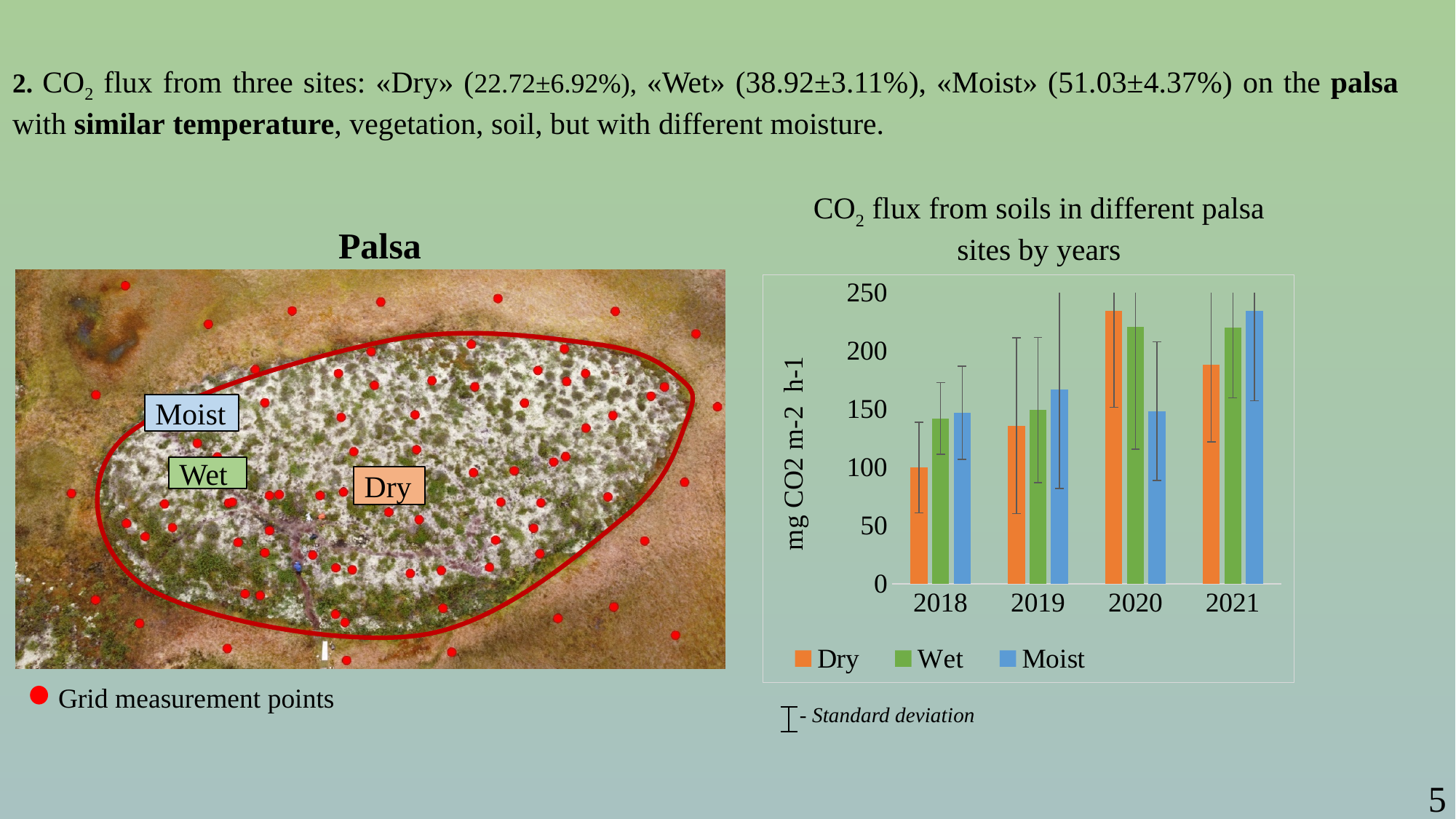
In the CO2 flux chart, which is larger in 2021: the Dry value or the Moist value? Moist In the CO2 flux chart, which year has the highest Moist value? 2021 In the CO2 flux chart, which year has the lowest Dry value? 2018 In the CO2 flux chart, is the Dry value for 2019 greater or less than 150? less How many years are shown on the x axis of the CO2 flux chart? 4 How many series does the legend of the CO2 flux chart list? 3 In the CO2 flux chart, which year has the highest Dry value? 2020 In the CO2 flux chart, is the Moist value for 2019 greater or less than 150? greater In the CO2 flux chart, is the Dry value for 2020 greater or less than 200? greater What kind of chart is shown on the right side of the slide? bar chart In the CO2 flux chart, which is larger in 2020: the Dry value or the Moist value? Dry What is the y-axis label of the CO2 flux chart? mg CO2 m-2 h-1